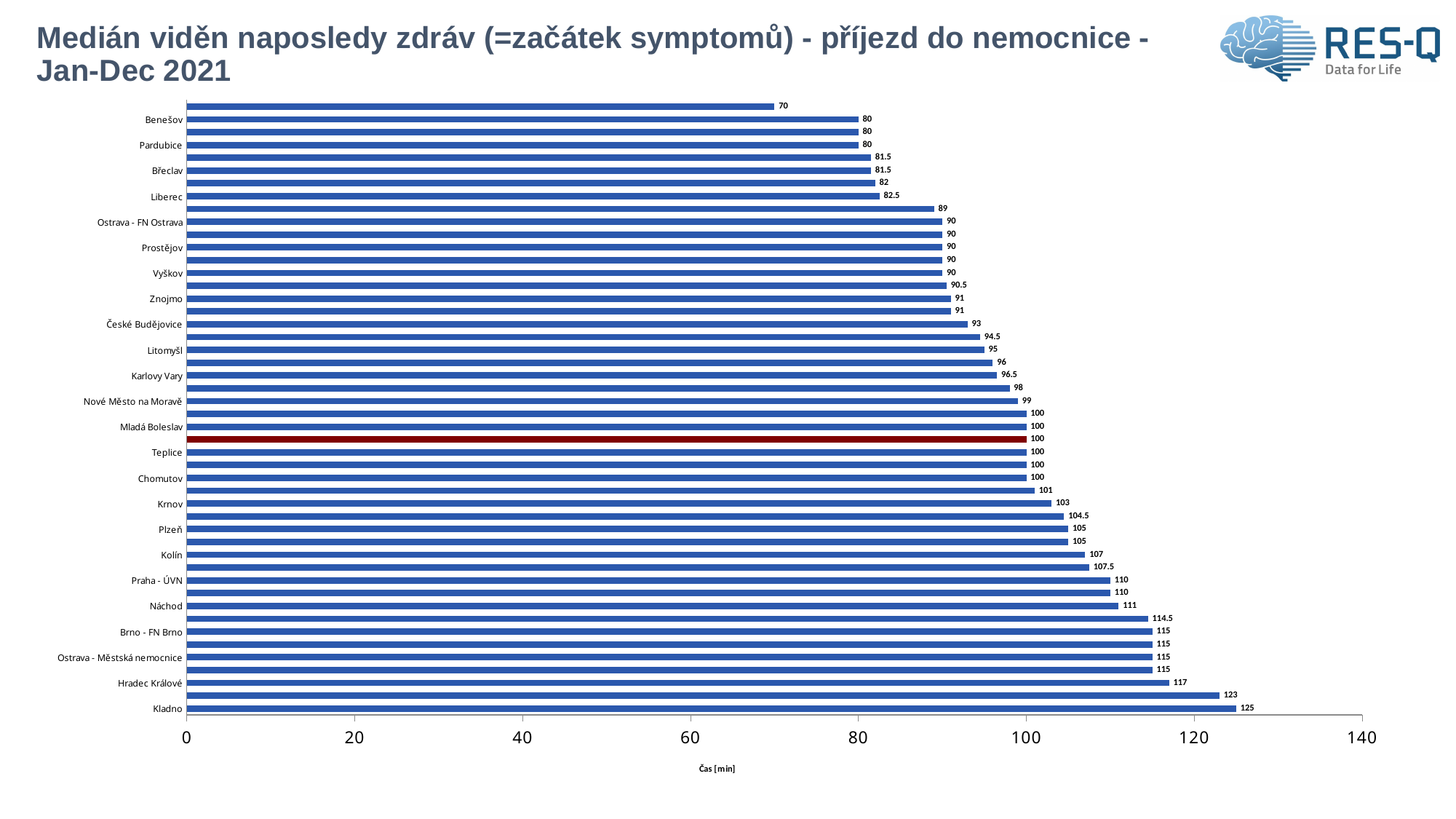
What type of chart is shown on the slide? bar chart Which has a larger value, Liberec or Krnov? Krnov What is the value for Plzeň? 105 What is the value for Kladno? 125 What is the value for Benešov? 80 What is the lowest value shown on the chart? 70 What is the value of the bar highlighted in dark red? 100 What is the value for Náchod? 111 What is the difference between the values for Kladno and Benešov? 45 What is the value for Hradec Králové? 117 Which labelled hospital has the highest value? Kladno Is the value for Brno - FN Brno greater or less than 100? greater